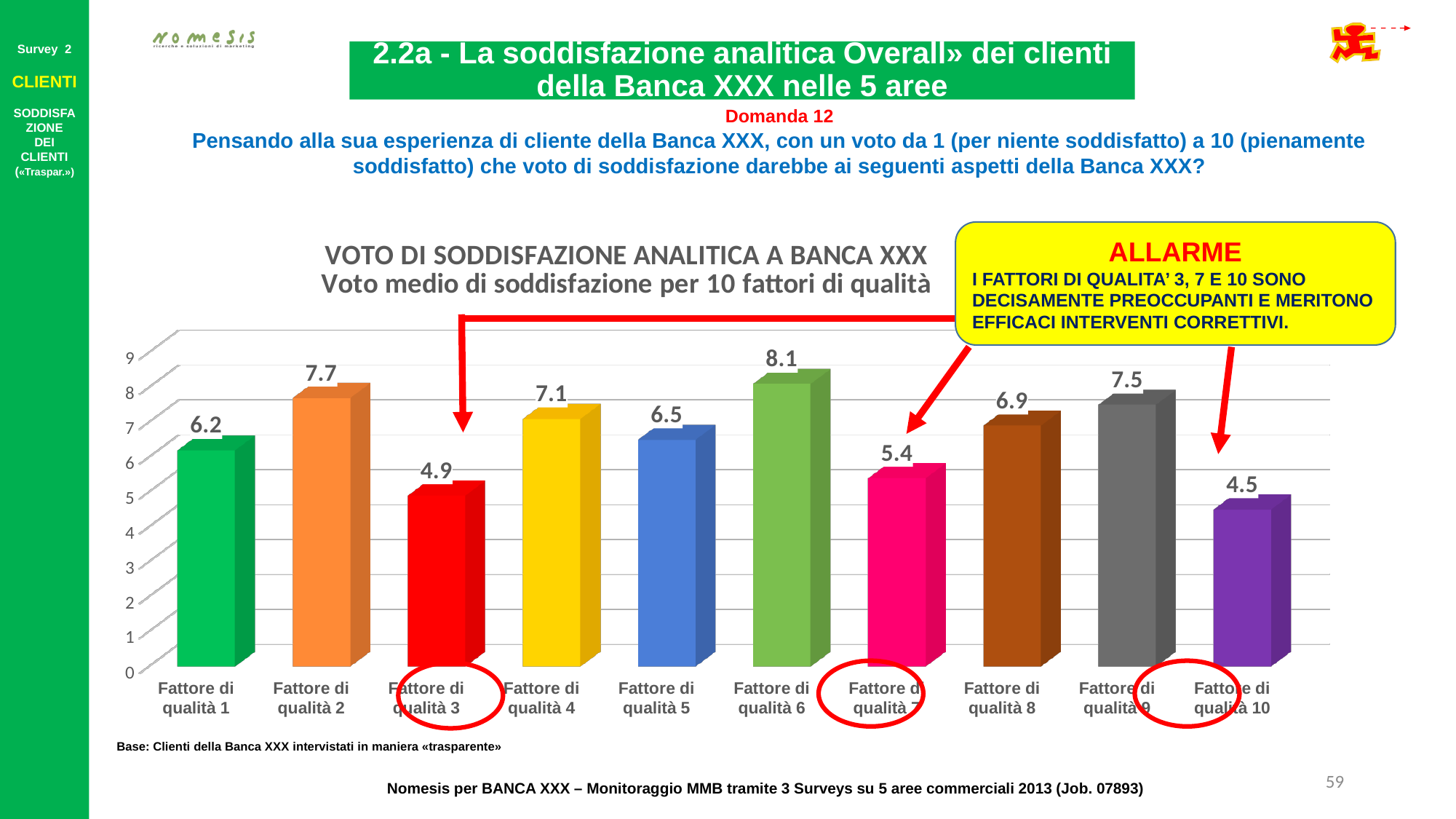
What is the value for Fattore di qualità 3? 4.9 Which is larger, the value for Fattore di qualità 4 or Fattore di qualità 9? Fattore di qualità 9 What is the value for Fattore di qualità 10? 4.5 What is the value for Fattore di qualità 6? 8.1 Which factor has the highest satisfaction score? Fattore di qualità 6 Which three factors are circled in red as alarming on the slide? Fattore di qualità 3, 7 and 10 Which factor has the lowest satisfaction score? Fattore di qualità 10 Is the value for Fattore di qualità 8 greater or less than 6? greater How many quality factors are shown in the chart? 10 What is the difference between the highest and lowest values in the chart? 3.6 What kind of chart is shown on the slide? bar chart What is the difference between the values for Fattore di qualità 2 and Fattore di qualità 7? 2.3